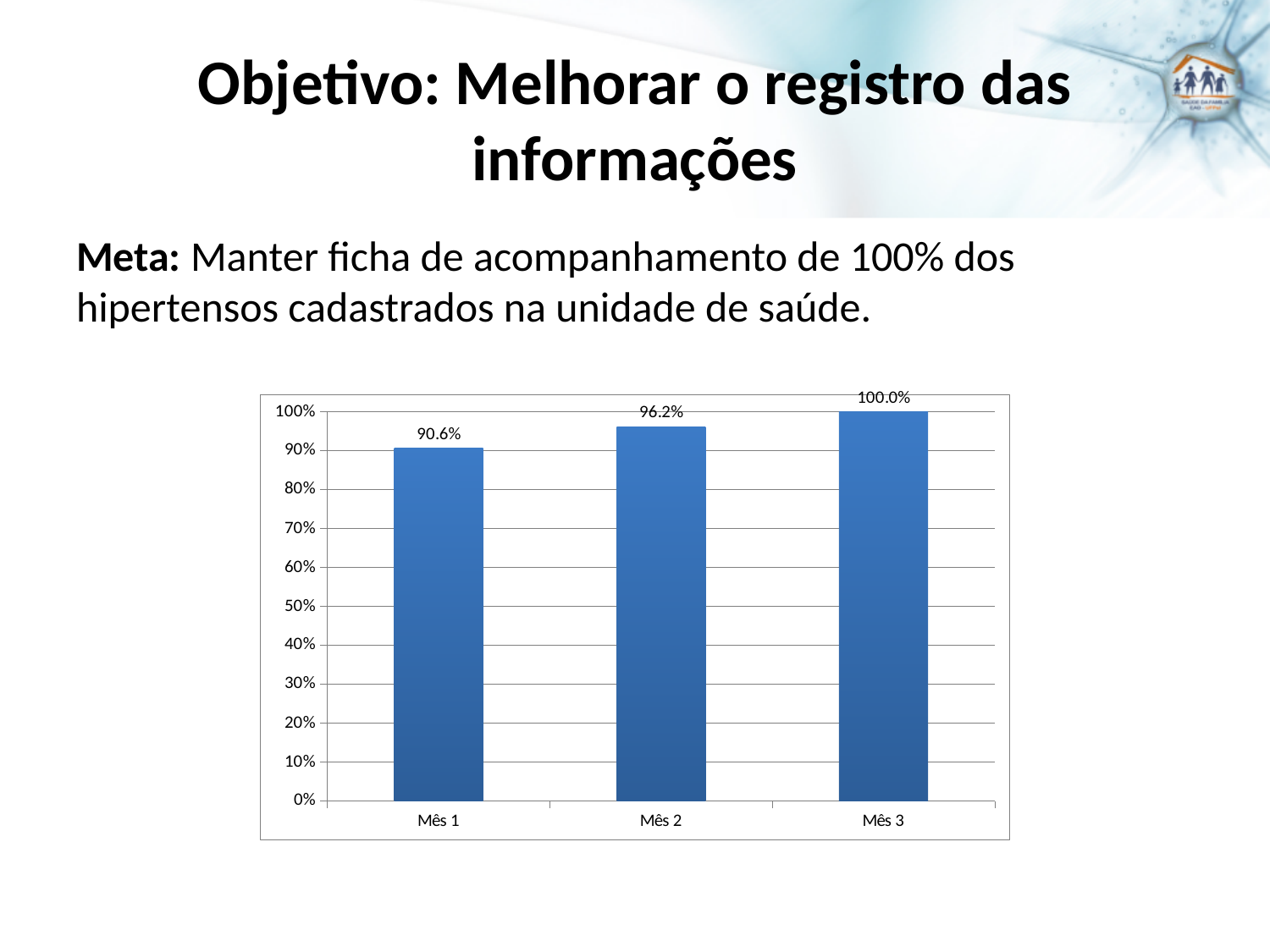
Which month has the highest value? Mês 3 What is the value for Mês 3? 100.0% What is the value for Mês 2? 96.2% What kind of chart is shown on the slide? bar chart How many categories are shown on the x axis? 3 Which month has the lowest value? Mês 1 Which is larger, the value for Mês 1 or the value for Mês 2? Mês 2 Is the value for Mês 1 greater or less than 80%? greater What is the value for Mês 1? 90.6% What is the difference between the values for Mês 2 and Mês 1? 5.6% Do the values rise or fall from Mês 1 to Mês 3? rise What is the difference between the values for Mês 3 and Mês 1? 9.4%